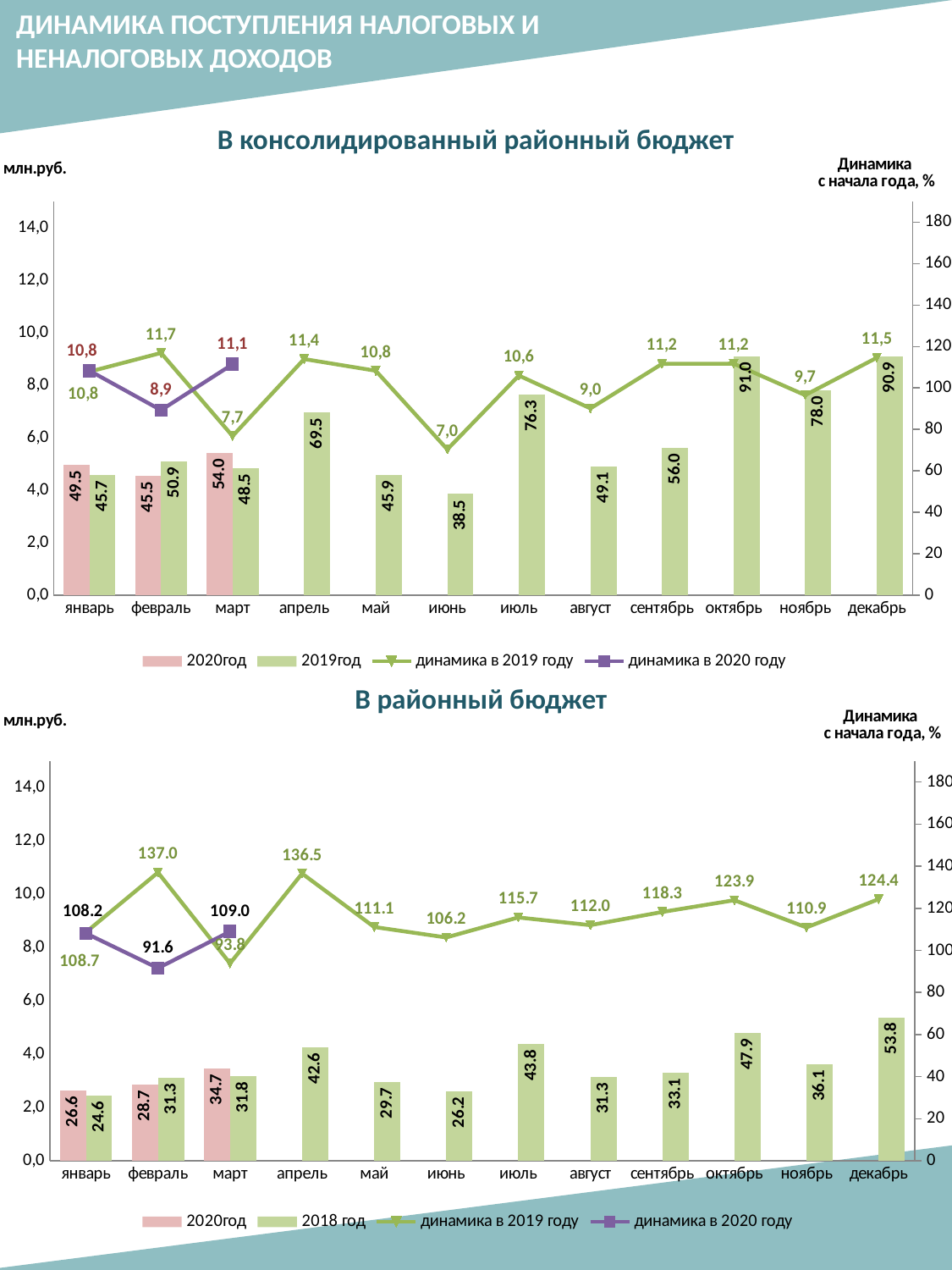
In the chart 'В районный бюджет', which month has the highest 2018 год bar? декабрь What type of chart is 'В районный бюджет'? Combined bar and line chart In the chart 'В районный бюджет', how many series does the legend list? 4 In the chart 'В консолидированный районный бюджет', what is the difference between the 2020год and 2019год bars for март? 5.5 In the chart 'В консолидированный районный бюджет', which month has the lowest 2019год bar? июнь In the chart 'В консолидированный районный бюджет', what is the value of the 2020год bar for март? 54.0 In the chart 'В консолидированный районный бюджет', what is the value of 'динамика в 2020 году' for февраль? 8,9 In the chart 'В районный бюджет', which is larger for февраль: the 2020год bar or the 2018 год bar? 2018 год In the chart 'В районный бюджет', what is the value of 'динамика в 2019 году' for февраль? 137.0 In the chart 'В консолидированный районный бюджет', how many months are shown on the x axis? 12 In the chart 'В консолидированный районный бюджет', what is the value of the 2019год bar for октябрь? 91.0 In the chart 'В районный бюджет', what is the value of the 2018 год bar for декабрь? 53.8